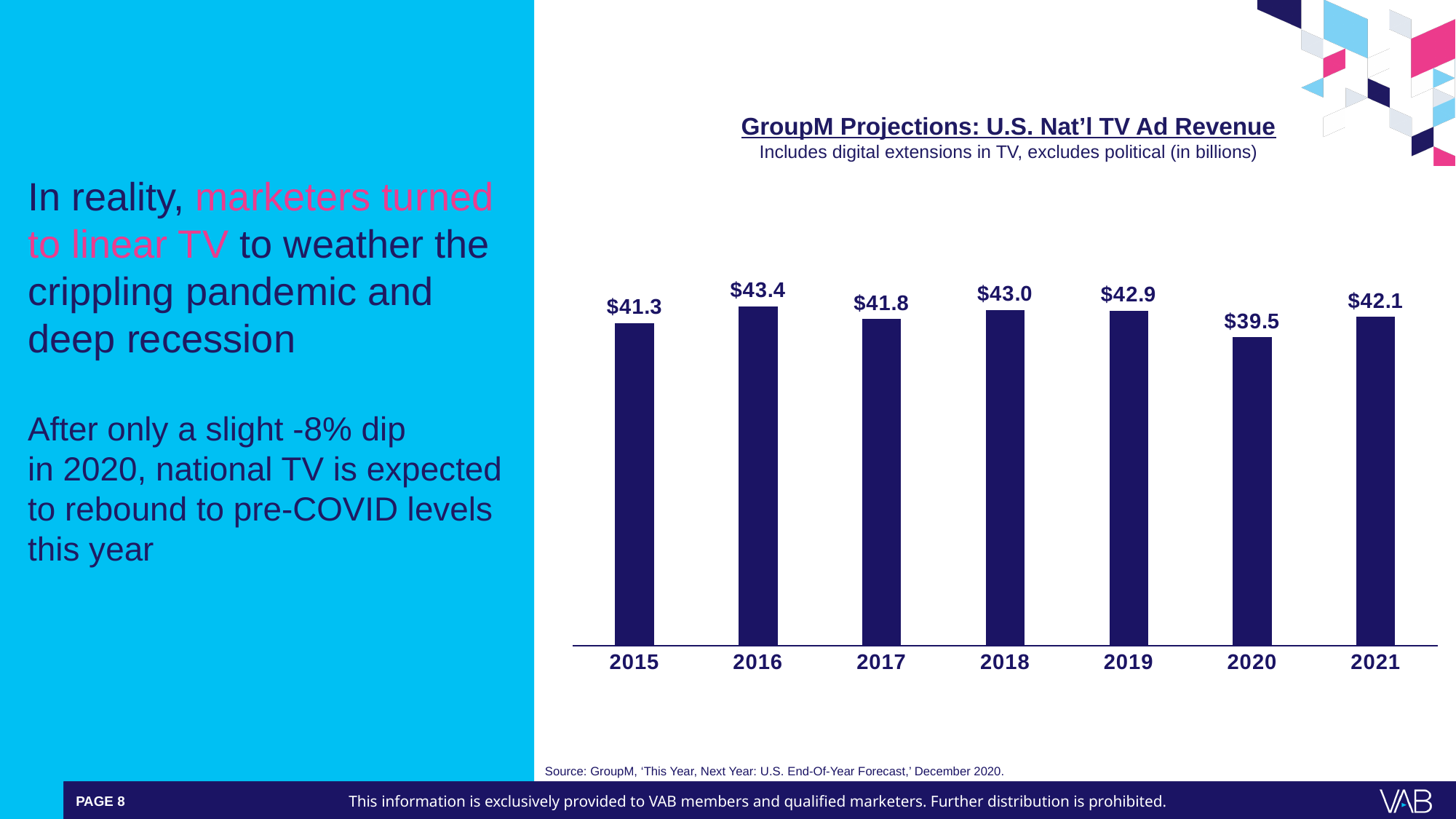
Which year has a larger value, 2017 or 2018? 2018 Which year has the highest U.S. national TV ad revenue on the chart? 2016 What is the projected U.S. national TV ad revenue for 2020? $39.5 What is the U.S. national TV ad revenue value shown for 2016? $43.4 What is the title of the chart? GroupM Projections: U.S. Nat'l TV Ad Revenue Which year has the lowest U.S. national TV ad revenue on the chart? 2020 How many years are shown on the chart? 7 What kind of chart is shown on the slide? Bar chart What is the difference between the 2016 value and the 2015 value? $2.1 Does the value rise or fall from 2019 to 2020? Fall What is the value shown for 2021? $42.1 What is the difference between the 2019 value and the 2020 value? $3.4